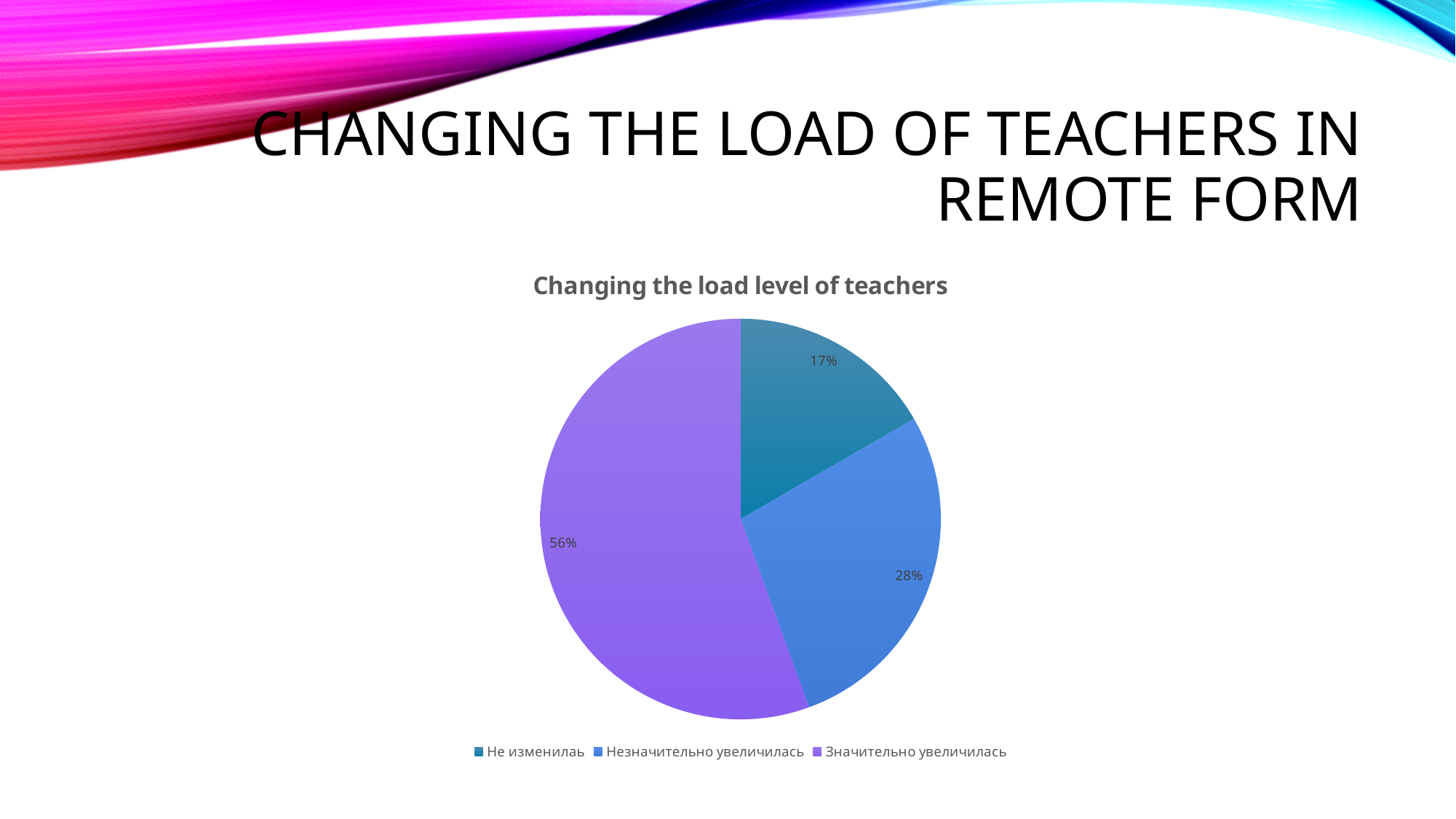
What colour is the slice for 'Значительно увеличилась'? purple Which category has the smallest slice of the pie? Не изменилаь Which slice is larger: 'Незначительно увеличилась' or 'Не изменилаь'? Незначительно увеличилась What is the title of the chart? Changing the load level of teachers What share of the pie does the slice 'Незначительно увеличилась' represent? 28% Which category has the largest slice of the pie? Значительно увеличилась What is the difference in percentage points between the 'Значительно увеличилась' slice and the 'Незначительно увеличилась' slice? 28 What type of chart is shown on the slide? pie chart How many entries does the legend list? 3 What share of the pie does the slice 'Значительно увеличилась' represent? 56% What share of the pie does the slice 'Не изменилаь' represent? 17% How many slices does the pie chart have? 3